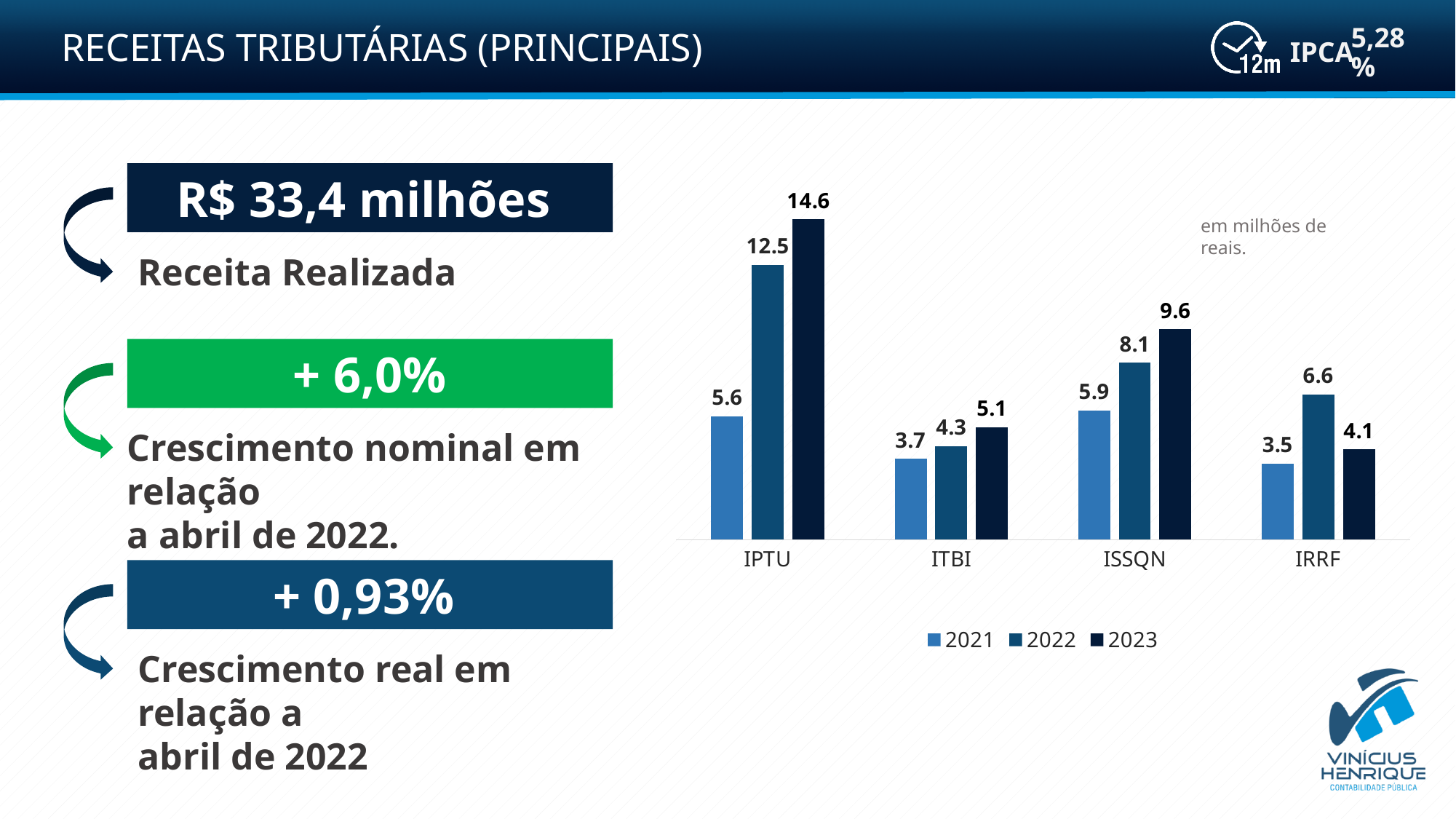
Which category has the lowest value in 2021? IRRF What kind of chart is shown on the slide? bar chart How many categories are shown on the x axis? 4 Do the values for ISSQN rise or fall from 2021 to 2023? rise What is the difference between the 2023 and 2022 values for IPTU? 2.1 Which is larger for IRRF, the 2022 value or the 2023 value? 2022 What is the difference between the 2022 and 2023 values for IRRF? 2.5 What is the value for ISSQN in 2022? 8.1 What is the value for IPTU in 2023? 14.6 What is the value for IRRF in 2021? 3.5 Which category has the highest value in 2023? IPTU How many series does the legend list? 3